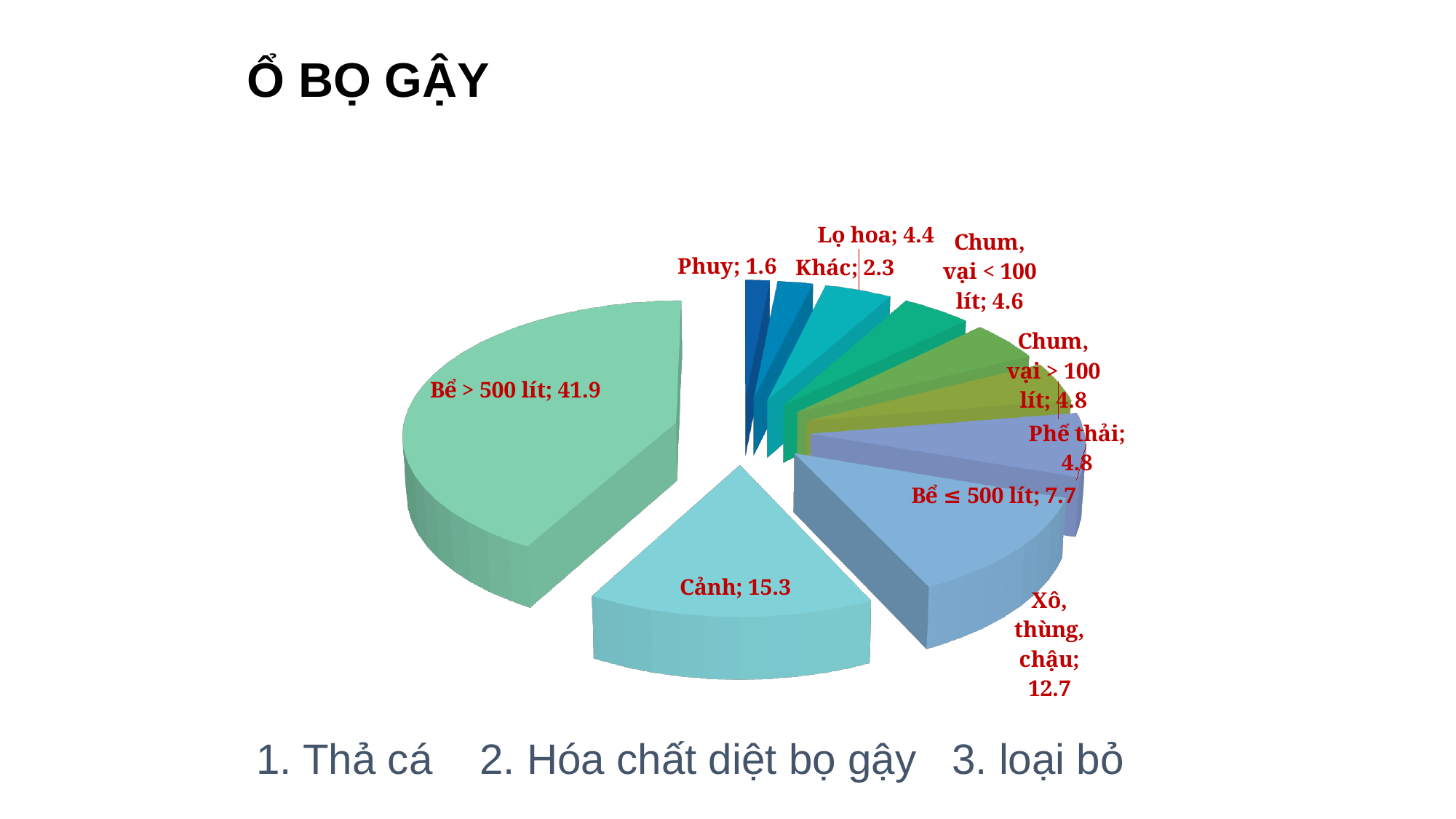
What is the value for Cảnh? 15.3 Which category has the smallest slice? Phuy What is the value for Xô, thùng, chậu? 12.7 What is the value for Bể > 500 lít? 41.9 What is the difference between the values for Khác and Phuy? 0.7 What type of chart is shown on the slide? Pie chart Which category has the largest slice? Bể > 500 lít Which is larger, the value for Bể ≤ 500 lít or the value for Phế thải? Bể ≤ 500 lít What is the title of the chart? Ổ BỌ GẬY What is the value for Lọ hoa? 4.4 What is the difference between the values for Bể > 500 lít and Cảnh? 26.6 How many categories are shown in the pie chart? 10